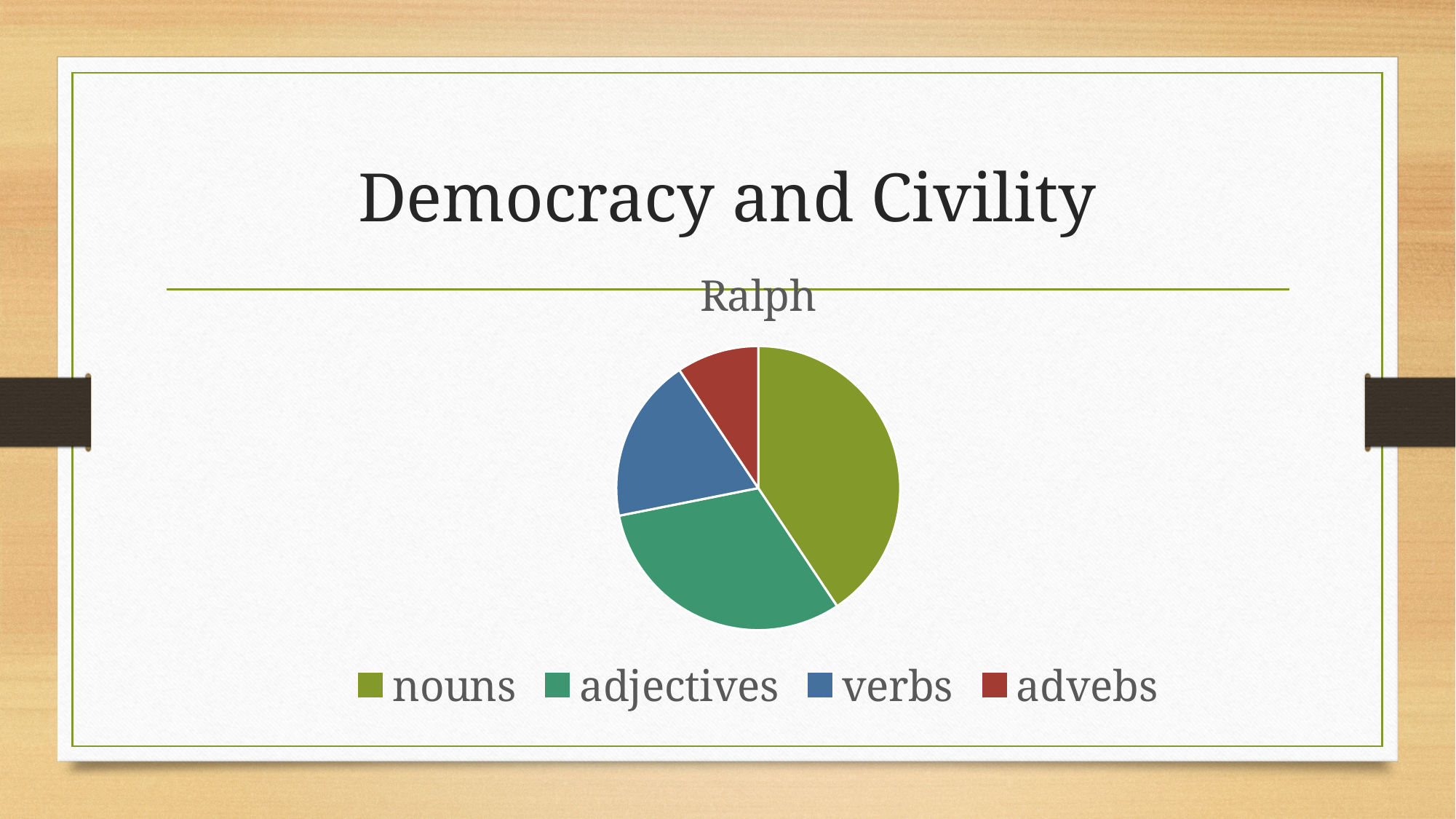
Which category is shown in red in the pie chart? advebs Which slice is larger, verbs or advebs? verbs What is the title of the chart? Ralph How many entries does the legend list? 4 Which category has the smallest slice of the pie? advebs What kind of chart is shown on the slide? pie chart How many slices does the pie chart have? 4 Which slice is larger, nouns or adjectives? nouns Which slice is larger, adjectives or verbs? adjectives Which category has the largest slice of the pie? nouns